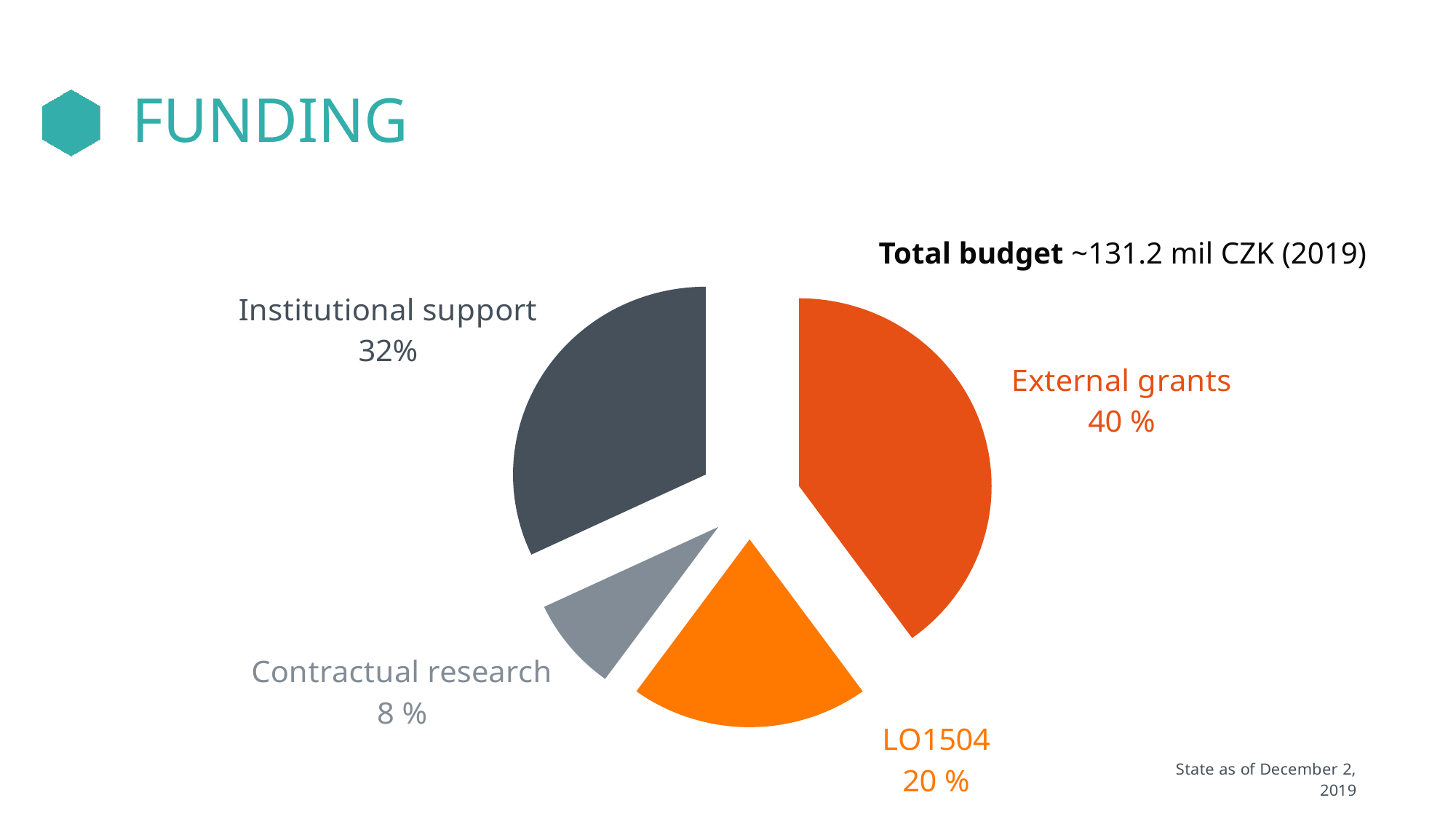
What total budget is stated on the slide? ~131.2 mil CZK (2019) How many slices does the pie chart have? 4 Which funding source has the largest share? External grants What kind of chart is shown on the slide? pie chart Which funding source has the smallest share? Contractual research What share of funding is Institutional support? 32% What share of funding comes from External grants? 40 % What share of funding comes from Contractual research? 8 % Which is larger, the share for Institutional support or the share for LO1504? Institutional support What share of funding comes from LO1504? 20 % What is the difference in percentage points between LO1504 and Contractual research? 12 What is the difference in percentage points between External grants and Institutional support? 8